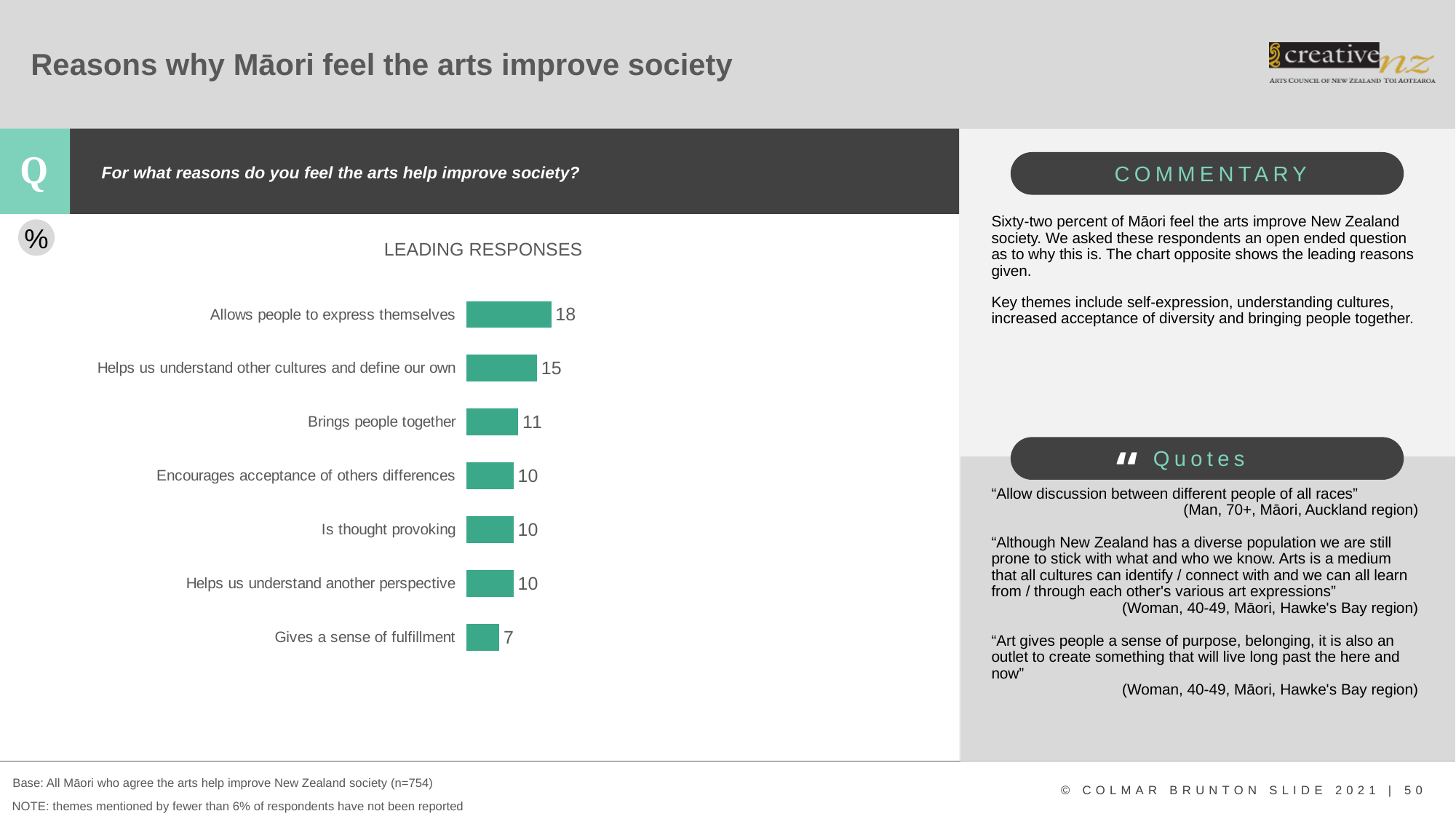
What is the difference between the values for "Brings people together" and "Gives a sense of fulfillment"? 4 What kind of chart is shown on the slide? Bar chart Which response has the lowest value? Gives a sense of fulfillment How many responses are shown in the chart? 7 What is the value for "Gives a sense of fulfillment"? 7 What is the title of the chart? LEADING RESPONSES What is the difference between the values for "Allows people to express themselves" and "Helps us understand other cultures and define our own"? 3 Which response has the highest value? Allows people to express themselves What is the value for "Helps us understand other cultures and define our own"? 15 What is the value for "Allows people to express themselves"? 18 Which is larger, the value for "Brings people together" or the value for "Is thought provoking"? Brings people together What is the value for "Brings people together"? 11